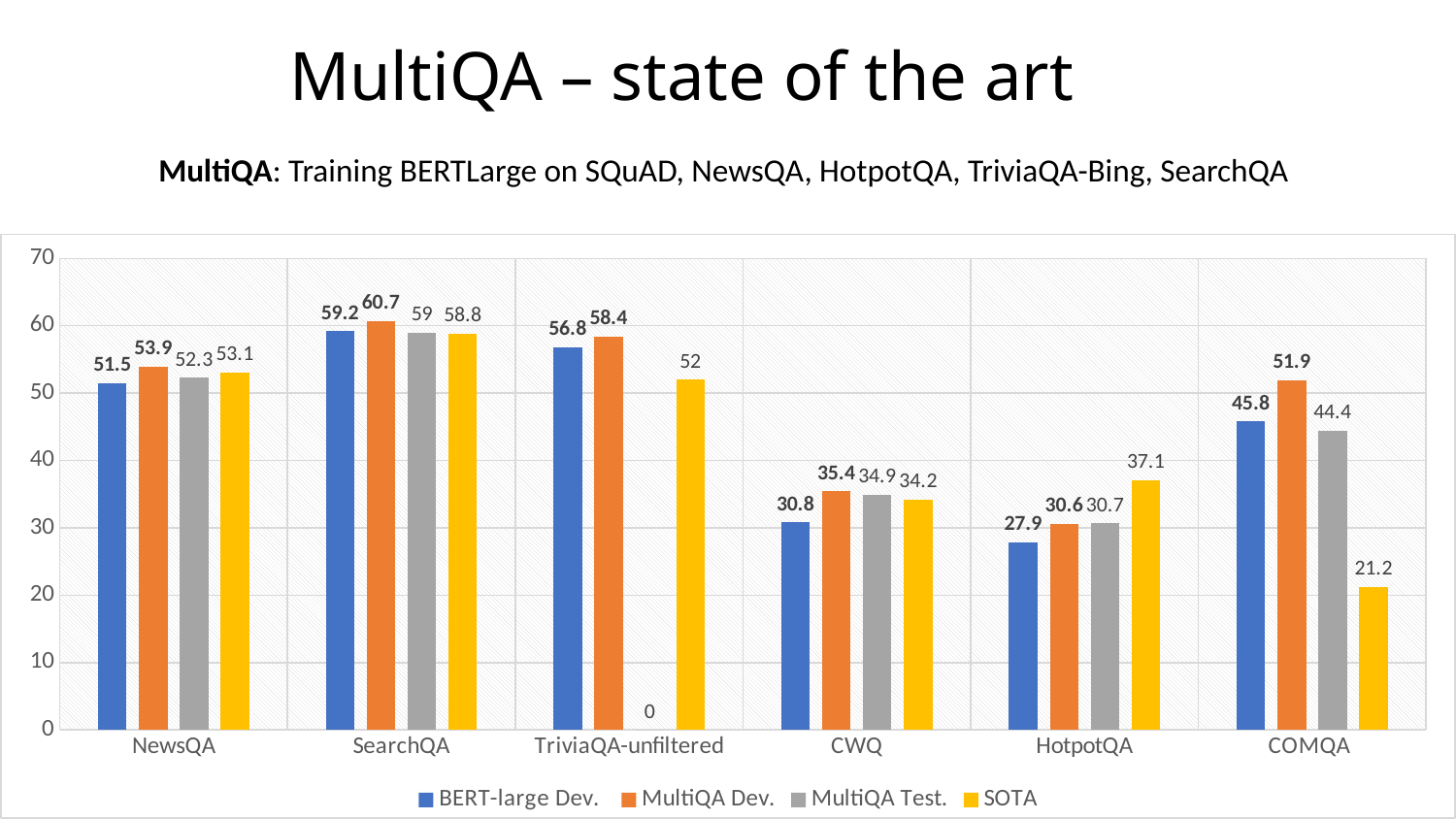
What kind of chart is shown on the slide? bar chart Which category has the highest SOTA value? SearchQA What is the MultiQA Dev. value for SearchQA? 60.7 What is the BERT-large Dev. value for HotpotQA? 27.9 How many series does the legend list? 4 Which category has the lowest BERT-large Dev. value? HotpotQA How many categories are shown on the x axis? 6 What is the SOTA value for COMQA? 21.2 Is the SOTA value for CWQ greater or less than 40? less What is the difference between the MultiQA Dev. and BERT-large Dev. values for COMQA? 6.1 What is the MultiQA Test. value for TriviaQA-unfiltered? 0 For HotpotQA, which is larger: the SOTA value or the MultiQA Dev. value? SOTA